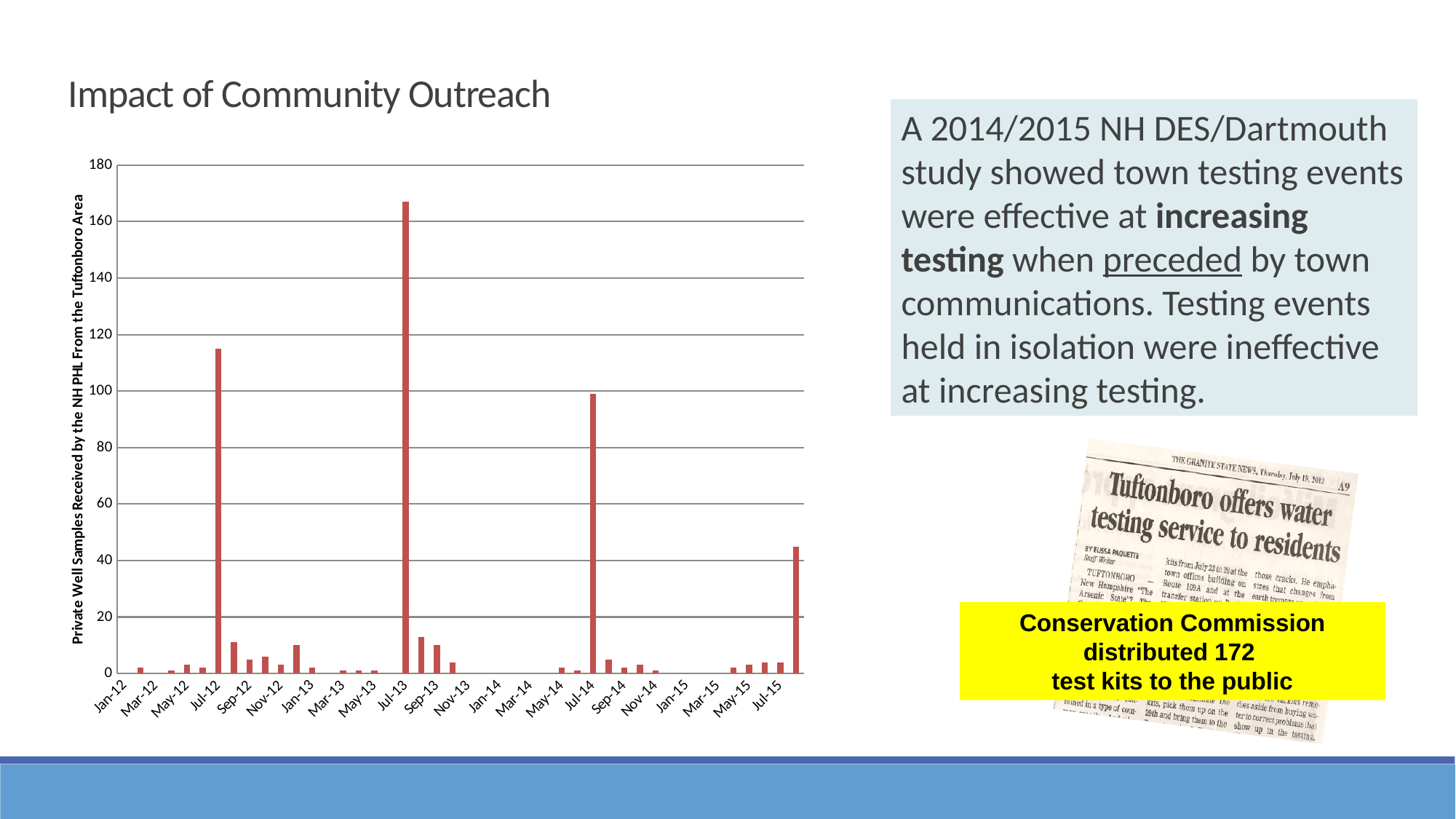
What is the highest value shown on the chart's y axis? 180 Which is larger, the value for Jul-12 or the value for Jul-14? Jul-12 Which month has the highest bar in the chart? Jul-13 Is the value for Jul-14 greater or less than 80? greater Is the value for Jul-12 greater or less than 100? greater Is the value for Jul-13 greater or less than 160? greater What kind of chart is shown on the slide? bar chart Which is larger, the value for Jul-13 or the value for Jul-12? Jul-13 How many month labels are shown along the chart's x axis? 22 What is the label of the chart's y axis? Private Well Samples Received by the NH PHL From the Tuftonboro Area